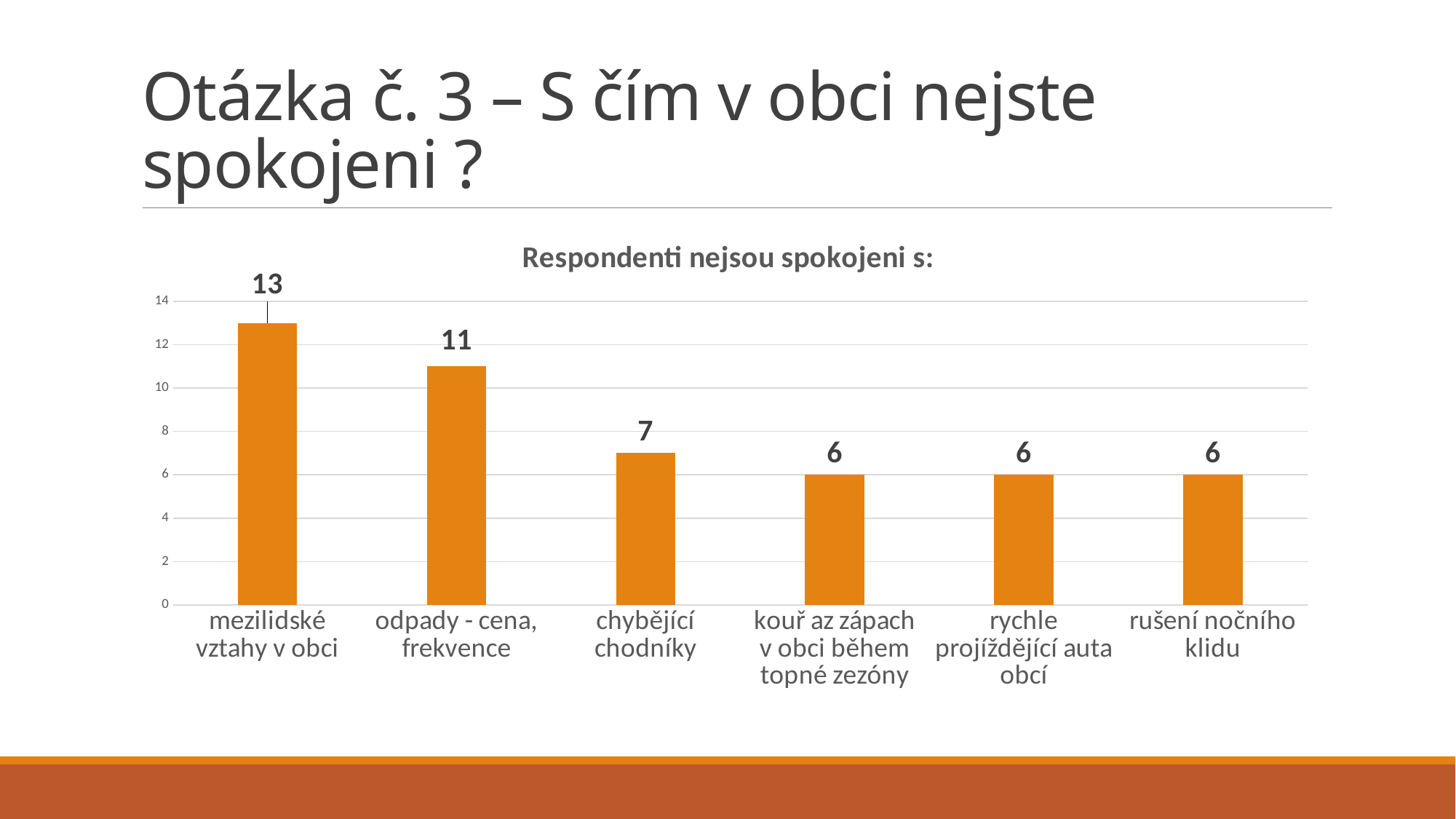
Which is larger: the value for 'chybějící chodníky' or the value for 'rychle projíždějící auta obcí'? chybějící chodníky What is the value for 'rušení nočního klidu'? 6 What is the value for 'odpady - cena, frekvence'? 11 What is the title of the chart? Respondenti nejsou spokojeni s: What is the difference between the values for 'odpady - cena, frekvence' and 'chybějící chodníky'? 4 How many categories are shown in the chart? 6 What is the difference between the values for 'mezilidské vztahy v obci' and 'odpady - cena, frekvence'? 2 What is the value for 'chybějící chodníky'? 7 Do the values rise or fall from left to right across the categories? fall What is the value for 'mezilidské vztahy v obci'? 13 What kind of chart is shown on the slide? bar chart Which category has the highest value? mezilidské vztahy v obci